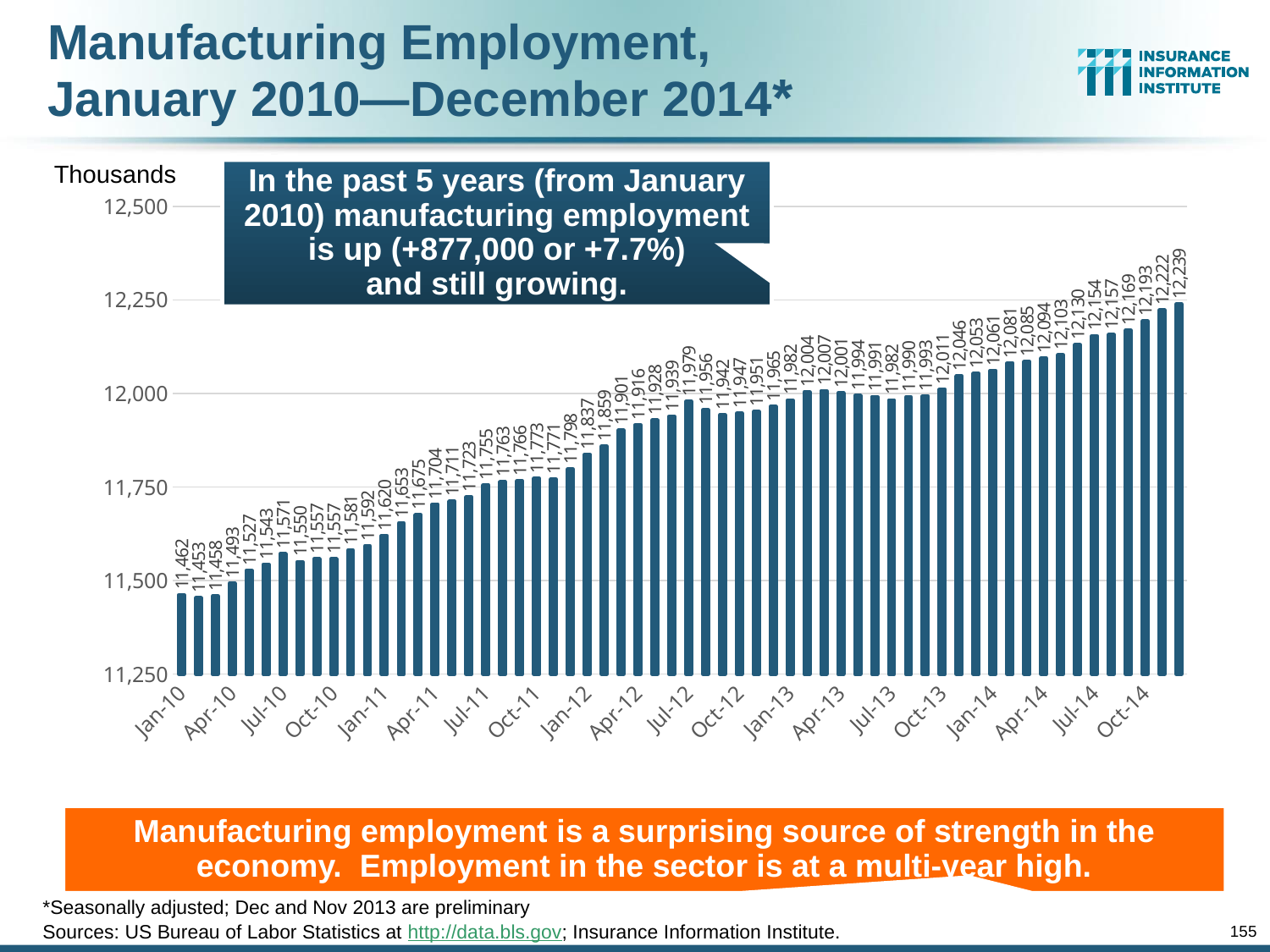
In what units are the values on the vertical axis expressed? Thousands What kind of chart is shown on the slide? Bar chart What is the lowest value shown on the chart? 11,453 What is the highest value shown on the chart? 12,239 How many monthly bars are plotted on the chart? 60 What is the manufacturing employment value for Jan-10, the first bar? 11,462 Which is larger, the value for Jan-12 or the value for Jan-11? Jan-12 Is the value for Jan-10 greater or less than 11,500? less What is the difference between the Jan-14 value (12,061) and the Jan-13 value (11,982)? 79 What is the value for Jan-14? 12,061 Do the values generally rise or fall from Jan-10 to Dec-14? Rise What is the value of the last bar (December 2014)? 12,239